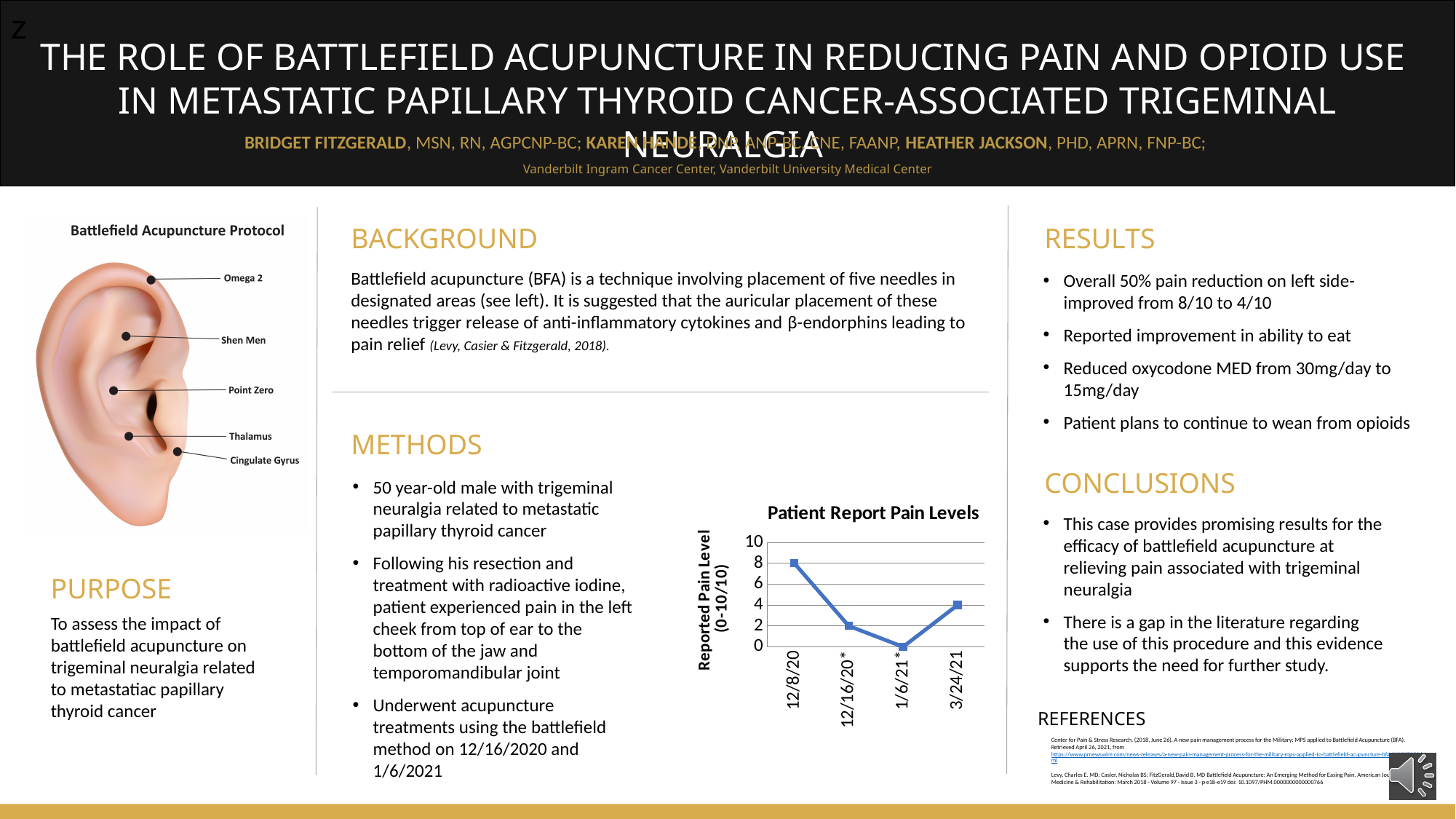
In the Patient Report Pain Levels chart, what is the reported pain level on 12/16/20*? 2 In the Patient Report Pain Levels chart, what is the reported pain level on 12/8/20? 8 In the Patient Report Pain Levels chart, what is the reported pain level on 1/6/21*? 0 What is the title of the chart on the slide? Patient Report Pain Levels In the Patient Report Pain Levels chart, what is the reported pain level on 3/24/21? 4 How many dates are plotted on the x axis of the Patient Report Pain Levels chart? 4 In the Patient Report Pain Levels chart, what is the difference between the pain level on 12/8/20 and on 3/24/21? 4 What kind of chart is the Patient Report Pain Levels chart? line chart What is the y-axis label of the Patient Report Pain Levels chart? Reported Pain Level (0-10/10) In the Patient Report Pain Levels chart, on which date is the reported pain level lowest? 1/6/21* In the Patient Report Pain Levels chart, on which date is the reported pain level highest? 12/8/20 In the Patient Report Pain Levels chart, which date has a higher pain level, 12/16/20* or 3/24/21? 3/24/21